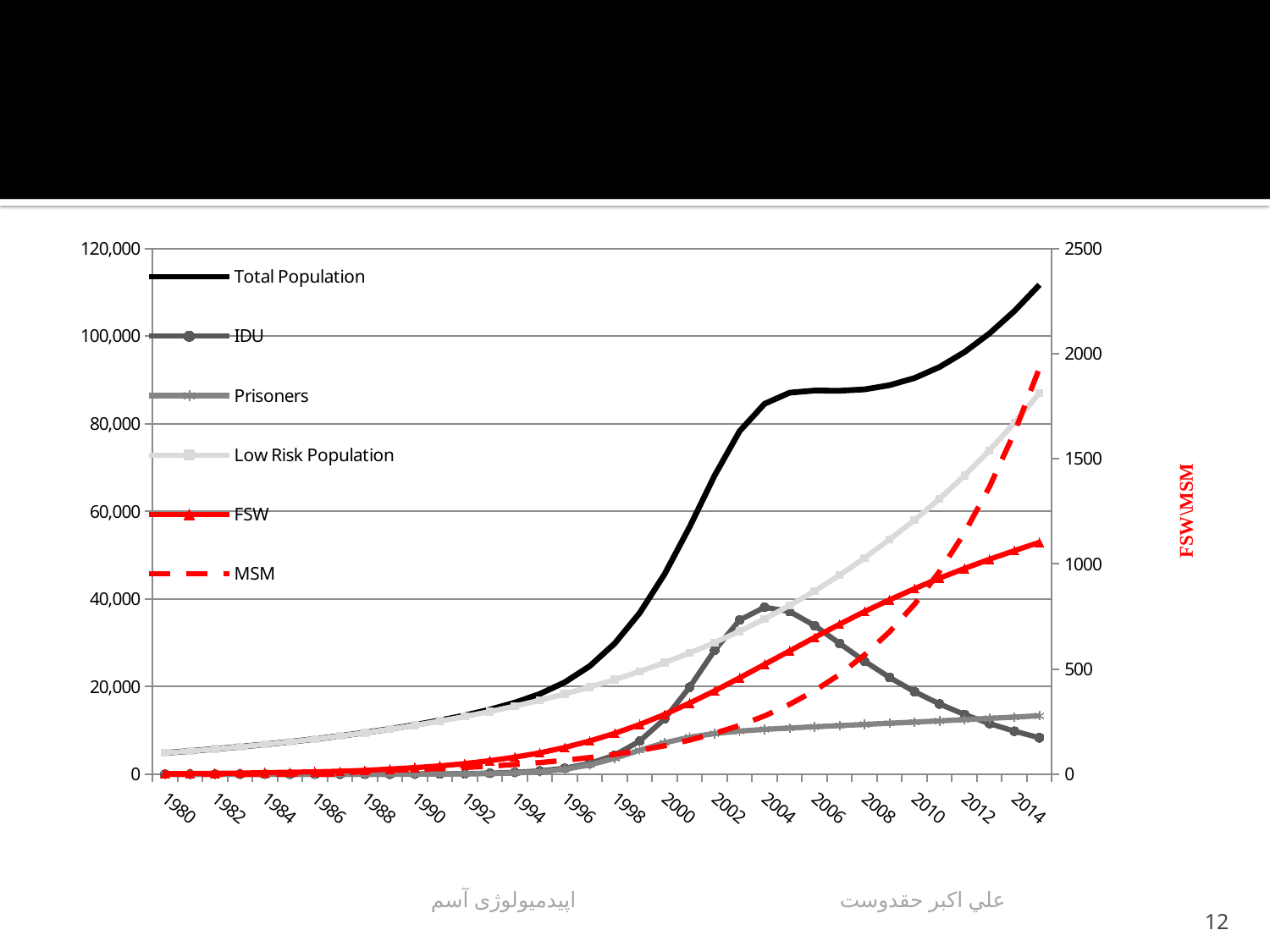
Is the value for MSM in 2014 greater or less than 1500 on the right axis? greater How many series does the legend list? 6 What kind of chart is shown on the slide? line chart Does the IDU series rise or fall between 2004 and 2014? fall Is the value for IDU in 2004 greater or less than 20,000? greater Which series is drawn with a dashed line? MSM What is the label of the right-hand vertical axis? FSW\MSM In 2014, which is higher: MSM or FSW? MSM Which series reaches the highest value on the left axis in 2014? Total Population Is the value for Prisoners in 2014 greater or less than 20,000? less